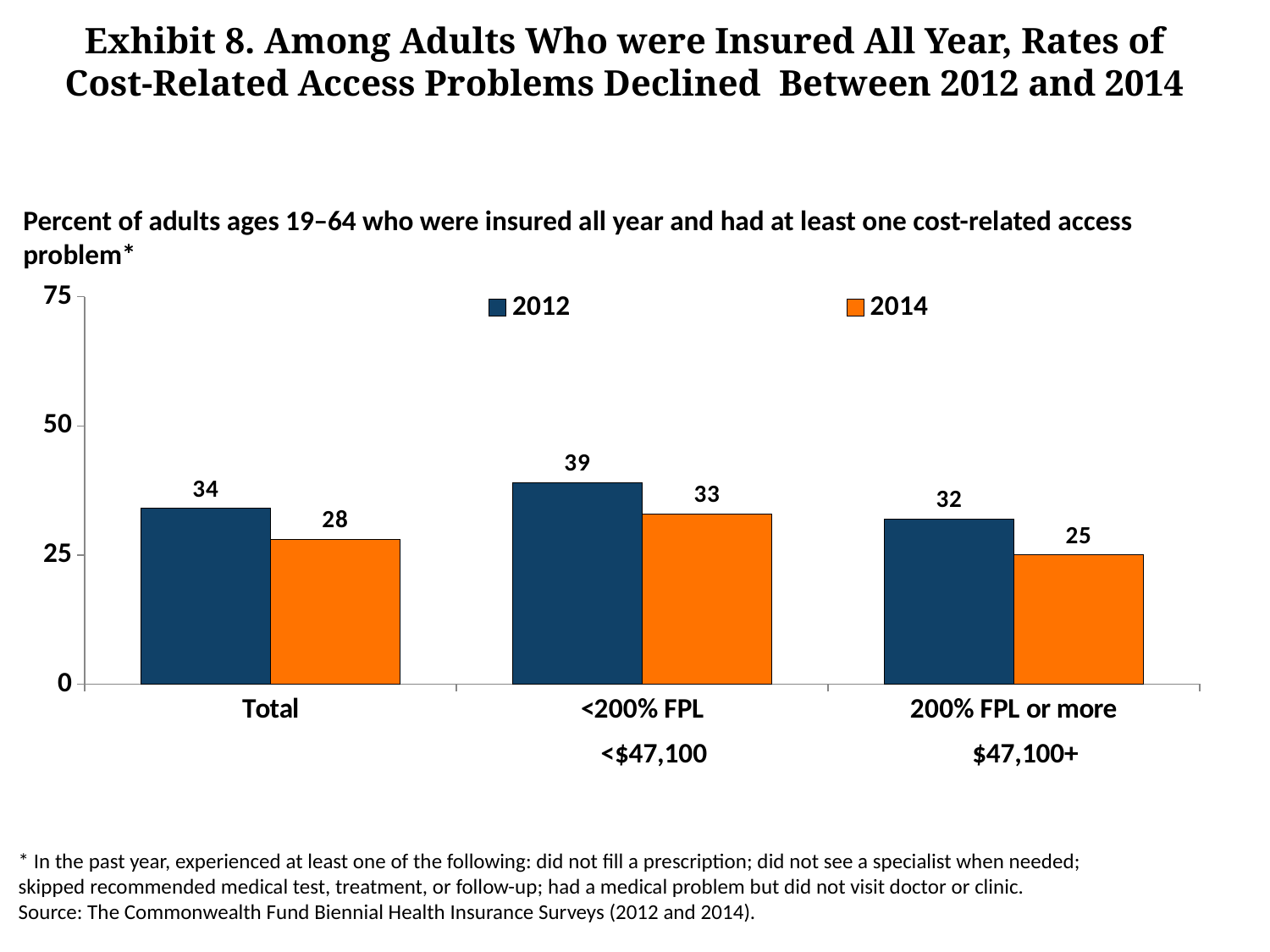
How many categories are shown on the x axis? 3 Which is larger: the 2012 value for <200% FPL or the 2012 value for 200% FPL or more? 2012 value for <200% FPL What is the 2012 value for Total? 34 What is the 2014 value for 200% FPL or more? 25 How many series does the legend list? 2 What is the difference between the 2012 and 2014 values for 200% FPL or more? 7 Which category has the lowest 2014 value? 200% FPL or more What is the 2014 value for <200% FPL? 33 What is the difference between the 2012 and 2014 values for Total? 6 What kind of chart is shown on the slide? bar chart Is the 2014 value for Total greater or less than 25? greater Which category has the highest 2012 value? <200% FPL